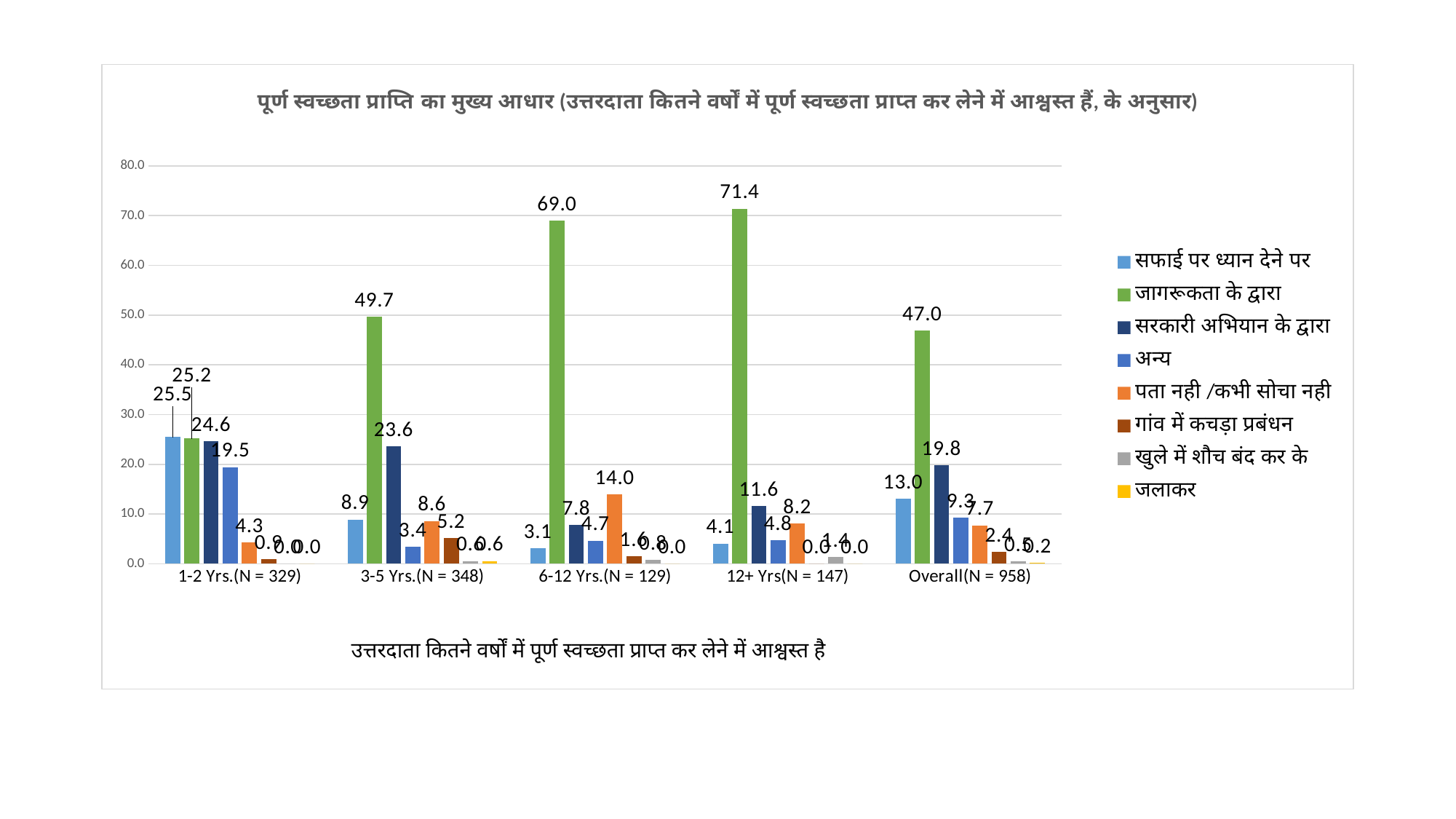
What is the value for सफाई पर ध्यान देने पर in the Overall(N = 958) category? 13.0 How many series does the legend list? 8 Which is larger in the Overall(N = 958) category: सरकारी अभियान के द्वारा or अन्य? सरकारी अभियान के द्वारा What is the difference between the जागरूकता के द्वारा values for 12+ Yrs(N = 147) and 6-12 Yrs.(N = 129)? 2.4 What is the value for पता नही /कभी सोचा नही in the 6-12 Yrs.(N = 129) category? 14.0 In which category is the value for सफाई पर ध्यान देने पर the lowest? 6-12 Yrs.(N = 129) What is the value for जागरूकता के द्वारा in the 12+ Yrs(N = 147) category? 71.4 In which category is the value for जागरूकता के द्वारा the highest? 12+ Yrs(N = 147) What kind of chart is shown on the slide? bar chart How many categories are shown on the x axis? 5 What is the value for सरकारी अभियान के द्वारा in the 3-5 Yrs.(N = 348) category? 23.6 Is the value for जागरूकता के द्वारा in the 3-5 Yrs.(N = 348) category greater or less than 40? greater